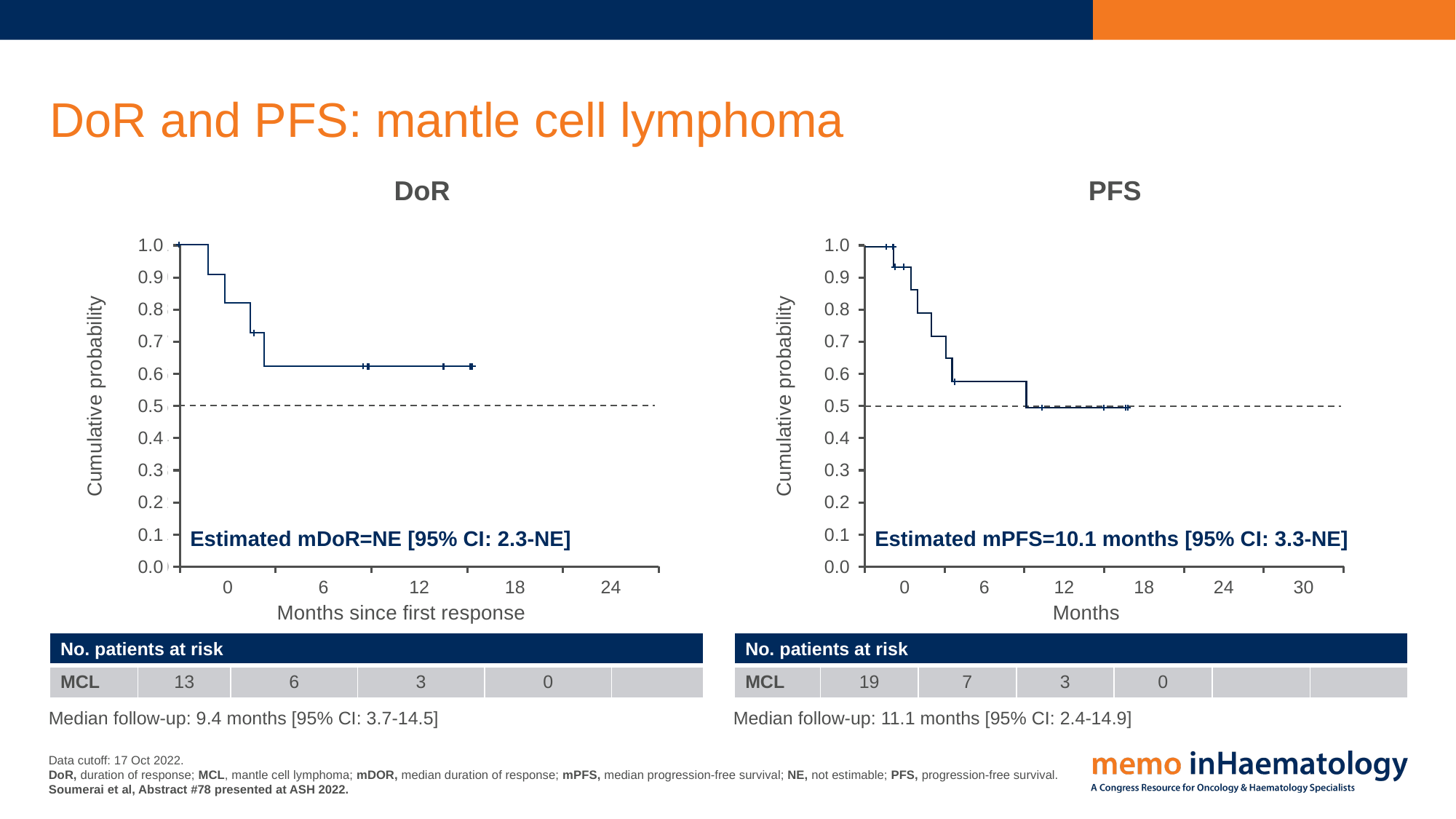
What is the estimated median PFS shown on the PFS chart? 10.1 months In the DoR chart, does the cumulative probability rise or fall as months since first response increase? fall What is the estimated median DoR shown on the DoR chart? NE In the PFS chart, how many patients are at risk at 12 months? 3 In the DoR chart, is the cumulative probability at 12 months greater or less than 0.5? greater In the PFS chart, how many MCL patients are at risk at 0 months? 19 What kind of chart is the PFS chart? Line chart (Kaplan-Meier curve) In the PFS chart, is the cumulative probability at 6 months greater or less than 0.5? greater In the DoR chart, how many MCL patients are at risk at 0 months? 13 What is the difference between the number of patients at risk at 0 months in the PFS chart and in the DoR chart? 6 In the DoR chart, how many patients are at risk at 6 months? 6 Which chart has more patients at risk at 6 months, DoR or PFS? PFS